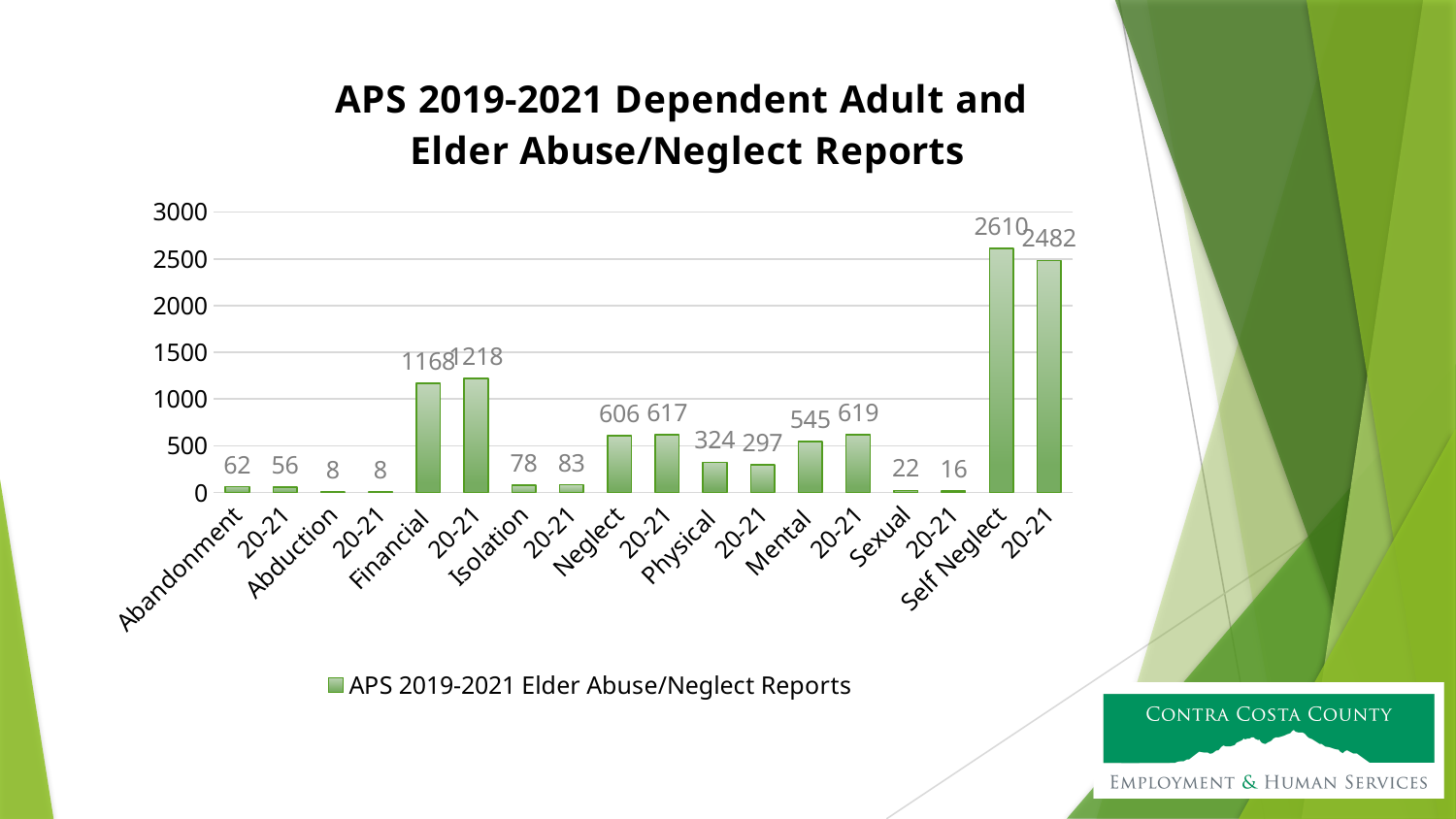
What is the value of the Financial bar? 1168 What is the difference between the Mental bar and the 20-21 bar that follows it? 74 What is the value of the Sexual bar? 22 Which is larger, the Neglect bar or the Mental bar? Neglect Which is larger, the Physical bar or the 20-21 bar that follows it? Physical Which category has the highest bar? Self Neglect What is the value of the Abandonment bar? 62 What type of chart is shown on the slide? Bar chart How many bars are plotted in the chart? 18 What is the difference between the Self Neglect bar (2610) and the 20-21 bar that follows it (2482)? 128 What is the value of the 20-21 bar immediately after Self Neglect? 2482 How many series does the legend list? 1